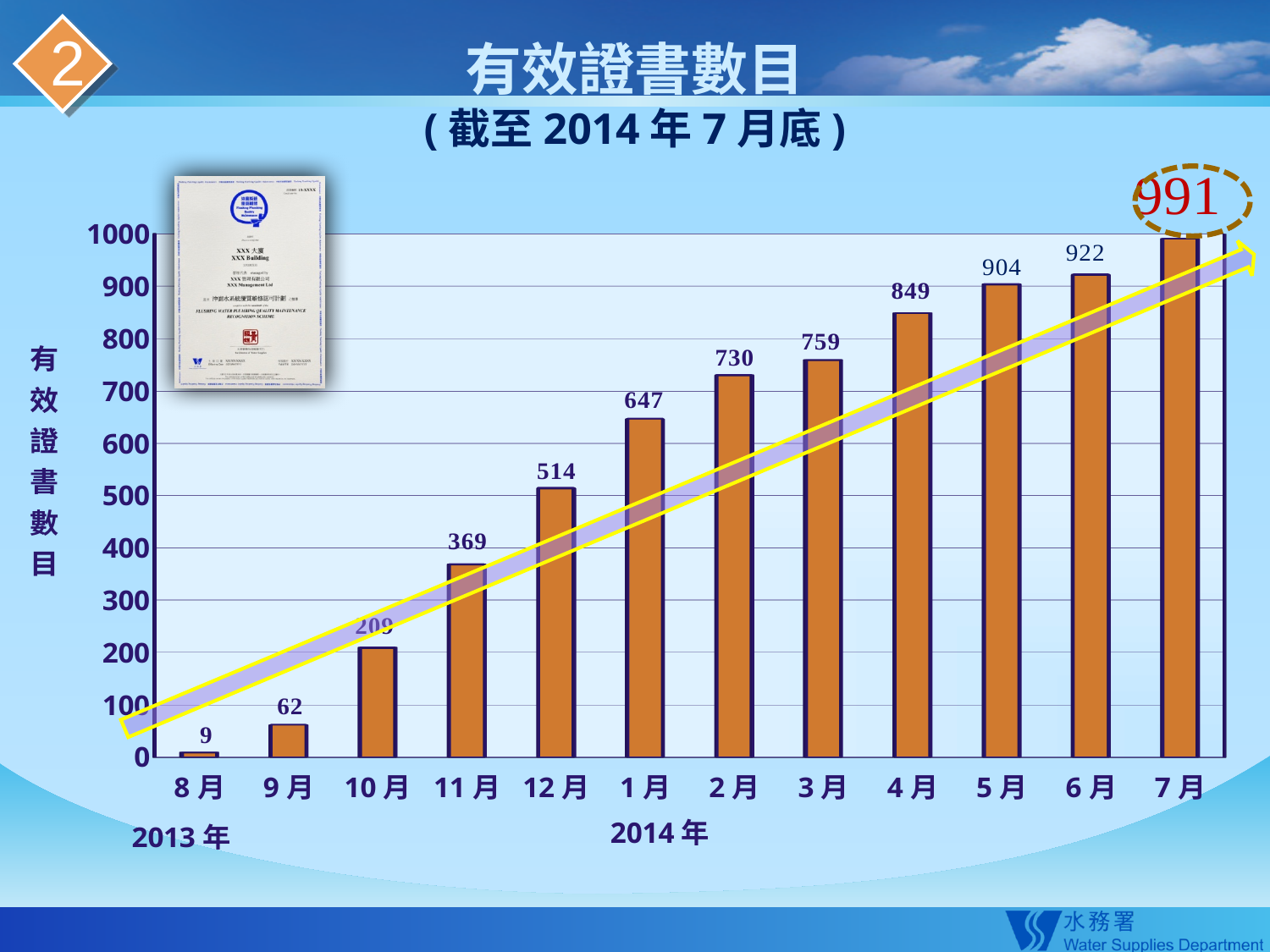
Which month has the lowest number of valid certificates? 8月 (2013年) How many months (bars) are shown in the chart? 12 What is the value shown for 12月 (2013年)? 514 What kind of chart is shown on the slide? Bar chart What is the difference between the values for 6月 and 5月 (2014年)? 18 What is the value shown for 8月 (2013年)? 9 Which is larger, the value for 2月 or the value for 3月 (2014年)? 3月 What is the value shown for 4月 (2014年)? 849 What is the number of valid certificates shown for 7月 (2014年)? 991 Do the values rise or fall from 8月 2013 to 7月 2014? Rise What is the difference between the values for 1月 and 12月? 133 Which month has the highest number of valid certificates? 7月 (2014年)